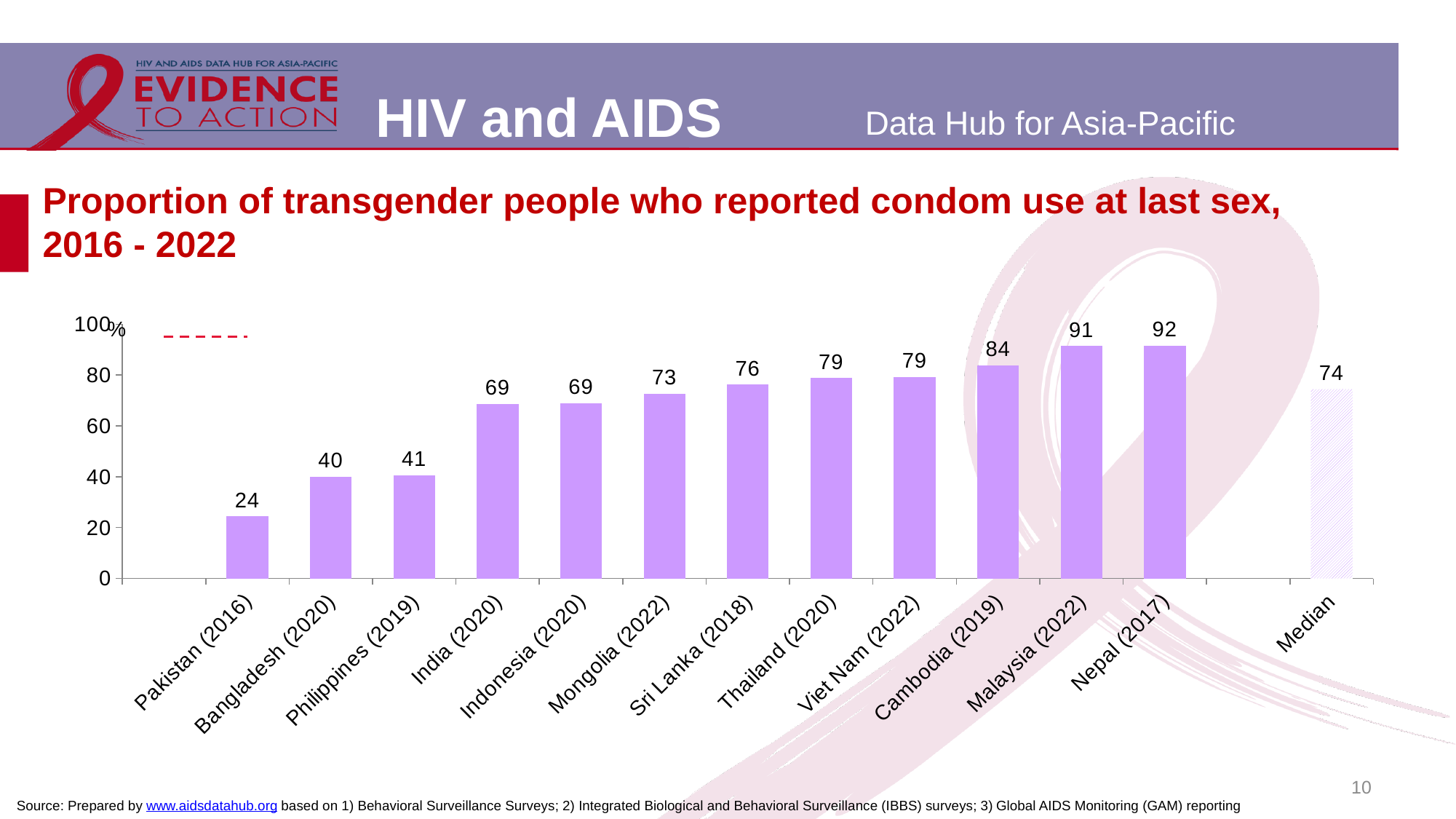
What is the value for Pakistan (2016)? 24 Which is larger, the value for Sri Lanka (2018) or the value for Mongolia (2022)? Sri Lanka (2018) Which country has the highest proportion of transgender people reporting condom use at last sex? Nepal (2017) What is the title of the chart? Proportion of transgender people who reported condom use at last sex, 2016 - 2022 Do the country values rise or fall from left to right along the x axis? Rise What is the value for Cambodia (2019)? 84 Is the value for Philippines (2019) greater or less than 60? less What kind of chart is shown on the slide? Bar chart What is the Median value shown on the chart? 74 What is the difference between the values for Malaysia (2022) and Bangladesh (2020)? 51 How many country bars are shown on the chart, excluding the Median bar? 12 Which country has the lowest proportion shown on the chart? Pakistan (2016)